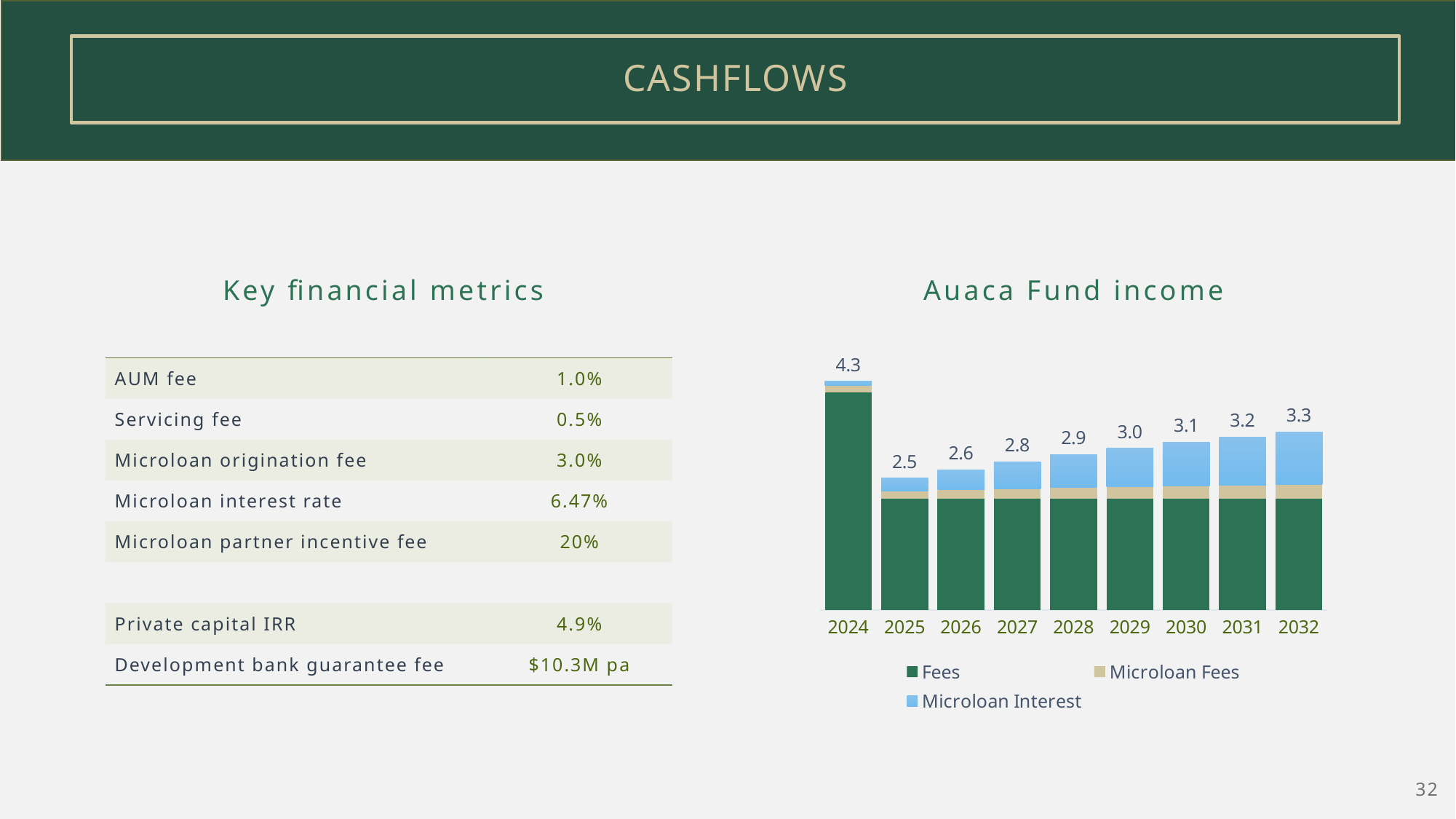
What kind of chart is the Auaca Fund income chart? Stacked bar chart What is the difference between the total income for 2024 and 2025 in the Auaca Fund income chart? 1.8 How many years are shown on the x axis of the Auaca Fund income chart? 9 What is the total income shown for 2028 in the Auaca Fund income chart? 2.9 Which series in the Auaca Fund income chart is shown in light blue? Microloan Interest Which year has a larger total income in the Auaca Fund income chart, 2027 or 2030? 2030 What is the total income shown for 2024 in the Auaca Fund income chart? 4.3 How many series does the legend of the Auaca Fund income chart list? 3 From 2025 to 2032, do the total income values in the Auaca Fund income chart rise or fall? Rise Which year has the highest total income in the Auaca Fund income chart? 2024 What is the total income shown for 2032 in the Auaca Fund income chart? 3.3 Which year has the lowest total income in the Auaca Fund income chart? 2025